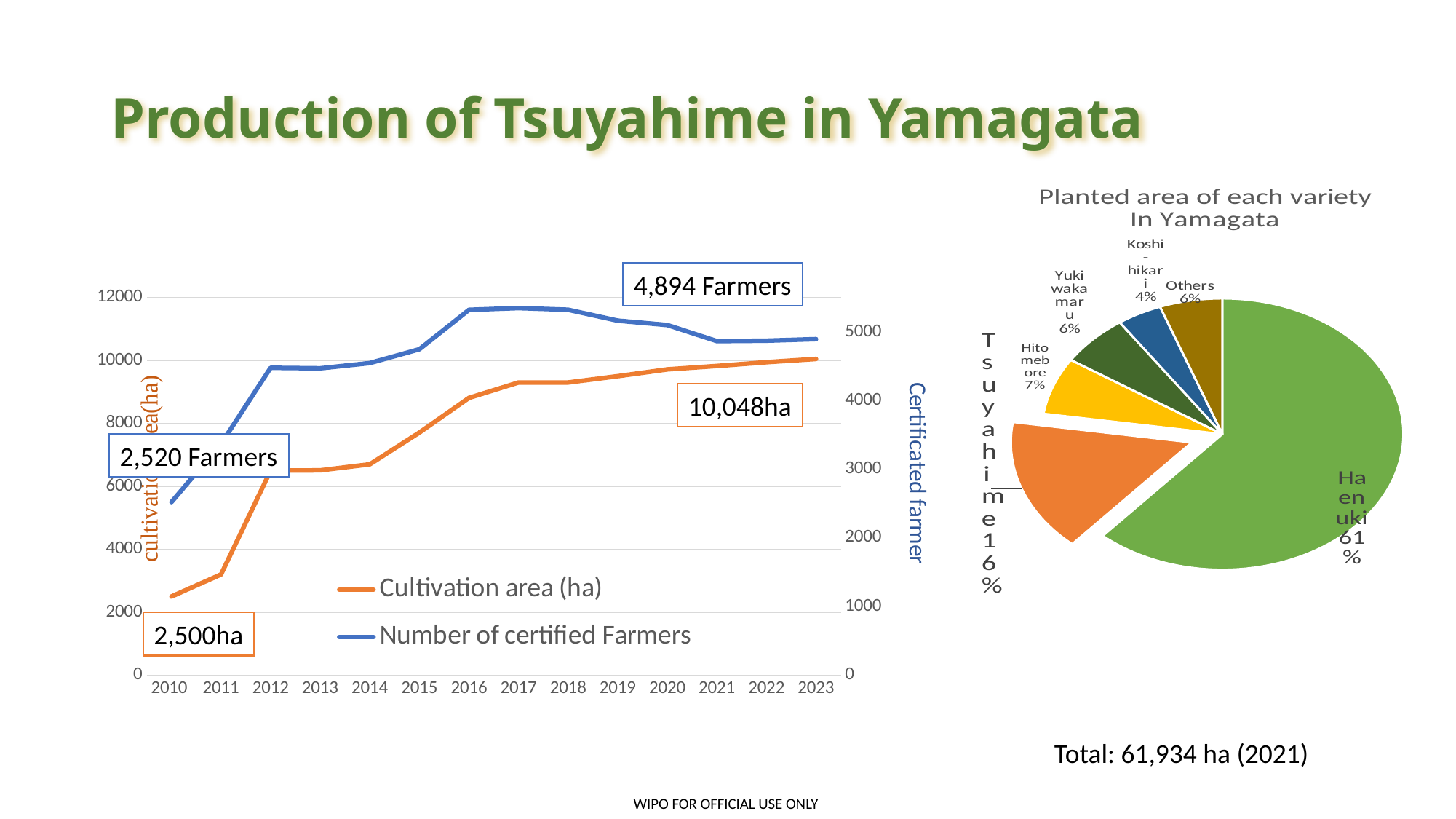
In the line chart on the left, does the cultivation area rise or fall from 2010 to 2023? rise In the line chart on the left, how many years are shown on the x axis? 14 What kind of chart is the chart on the left of the slide? line chart In the line chart on the left, by how much did the number of certified farmers increase from 2010 to 2023? 2,374 In the line chart on the left, what is the cultivation area in 2023? 10,048ha In the 'Planted area of each variety In Yamagata' pie chart, which variety has the largest share? Haenuki In the 'Planted area of each variety In Yamagata' pie chart, which has the larger share, Hitomebore or Yukiwakamaru? Hitomebore In the line chart on the left, how many series does the legend list? 2 In the line chart on the left, is the number of certified farmers in 2016 greater or less than 5000? greater In the line chart on the left, how many certified farmers were there in 2010? 2,520 Farmers In the 'Planted area of each variety In Yamagata' pie chart, what share does Tsuyahime have? 16% What kind of chart is the 'Planted area of each variety In Yamagata' chart? pie chart